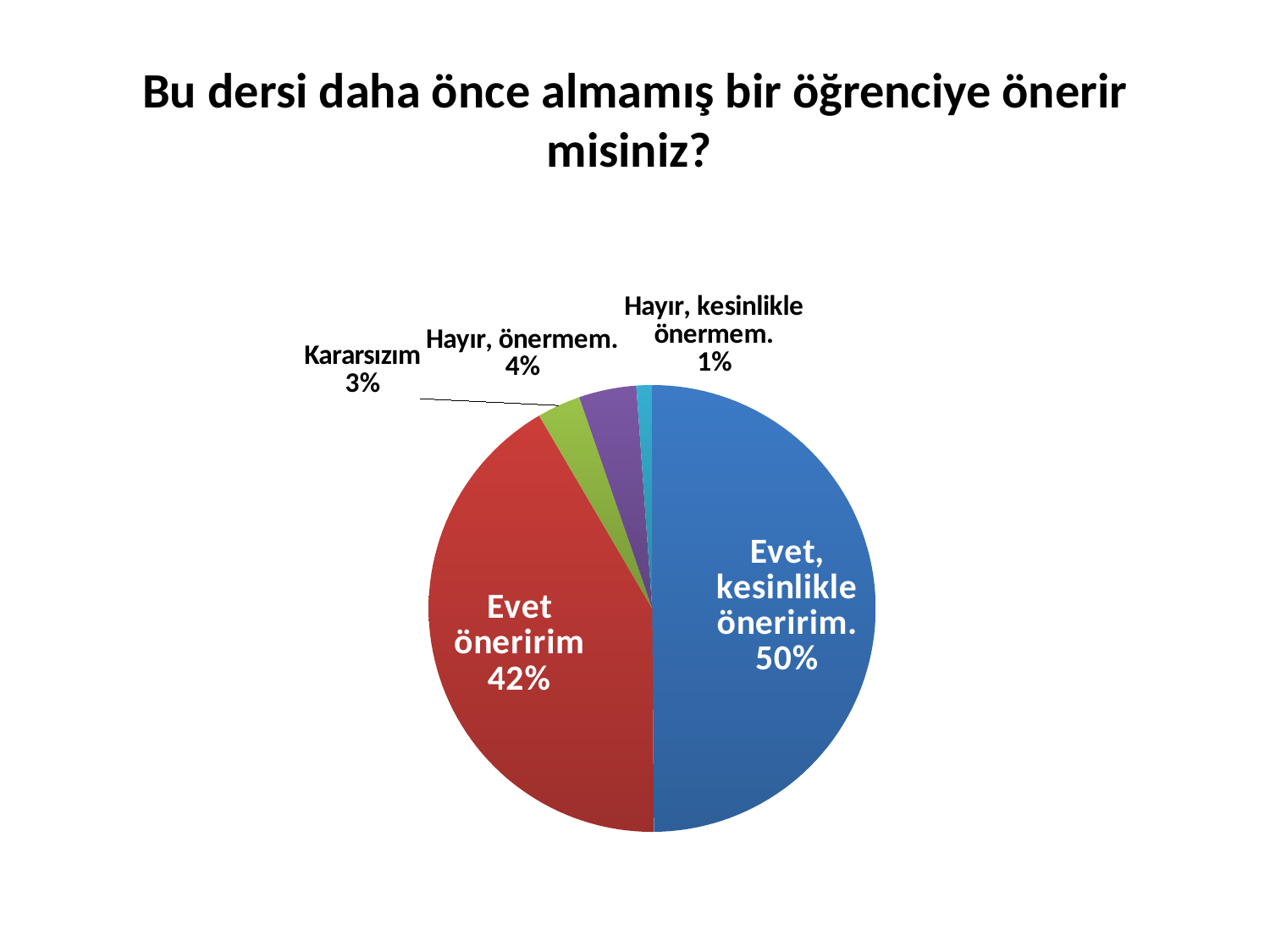
What kind of chart is shown on the slide? Pie chart What is the value shown for "Hayır, önermem."? 4% What is the value shown for "Hayır, kesinlikle önermem."? 1% Which category has the largest slice of the pie? Evet, kesinlikle öneririm. What is the title of the slide? Bu dersi daha önce almamış bir öğrenciye önerir misiniz? How many categories are shown in the pie chart? 5 What is the difference between the values for "Evet, kesinlikle öneririm." and "Evet öneririm"? 8% Which category has the smallest slice of the pie? Hayır, kesinlikle önermem. What share of the pie does "Evet, kesinlikle öneririm." represent? 50% What is the value shown for "Kararsızım"? 3% Which is larger, the value for "Hayır, önermem." or the value for "Kararsızım"? Hayır, önermem. What is the value shown for "Evet öneririm"? 42%